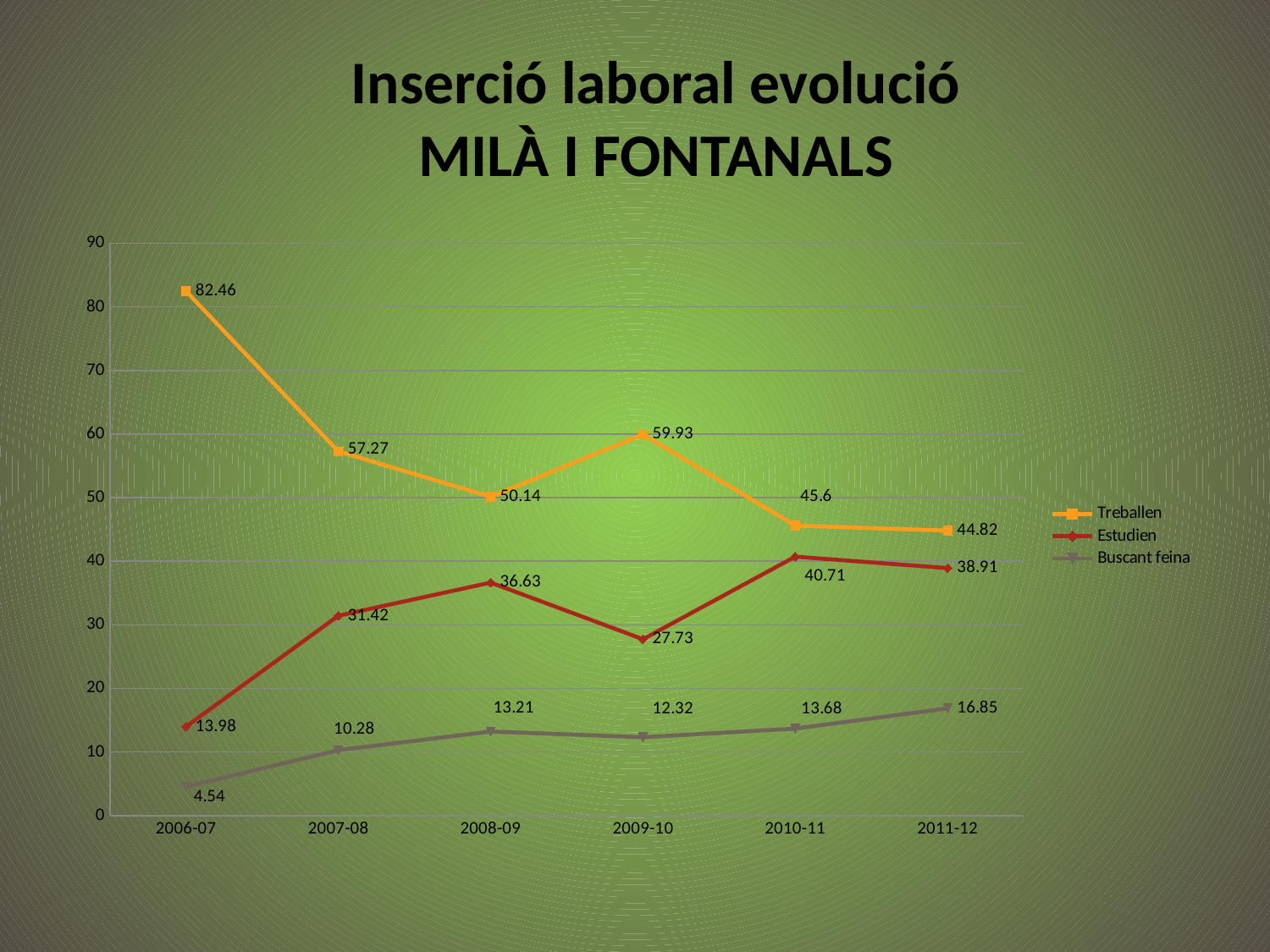
How many series does the legend list? 3 In which year is the Buscant feina series lowest? 2006-07 In which year is the Treballen series highest? 2006-07 What is the value for Buscant feina in 2011-12? 16.85 Does the Treballen series generally rise or fall from 2006-07 to 2011-12? Fall Which is larger in 2010-11, Estudien or Buscant feina? Estudien Is the value for Treballen in 2009-10 greater or less than 50? greater What kind of chart is shown on the slide? Line chart What is the value for Treballen in 2006-07? 82.46 What is the value for Estudien in 2009-10? 27.73 What is the difference between Treballen and Estudien in 2011-12? 5.91 How many years are shown on the x axis? 6